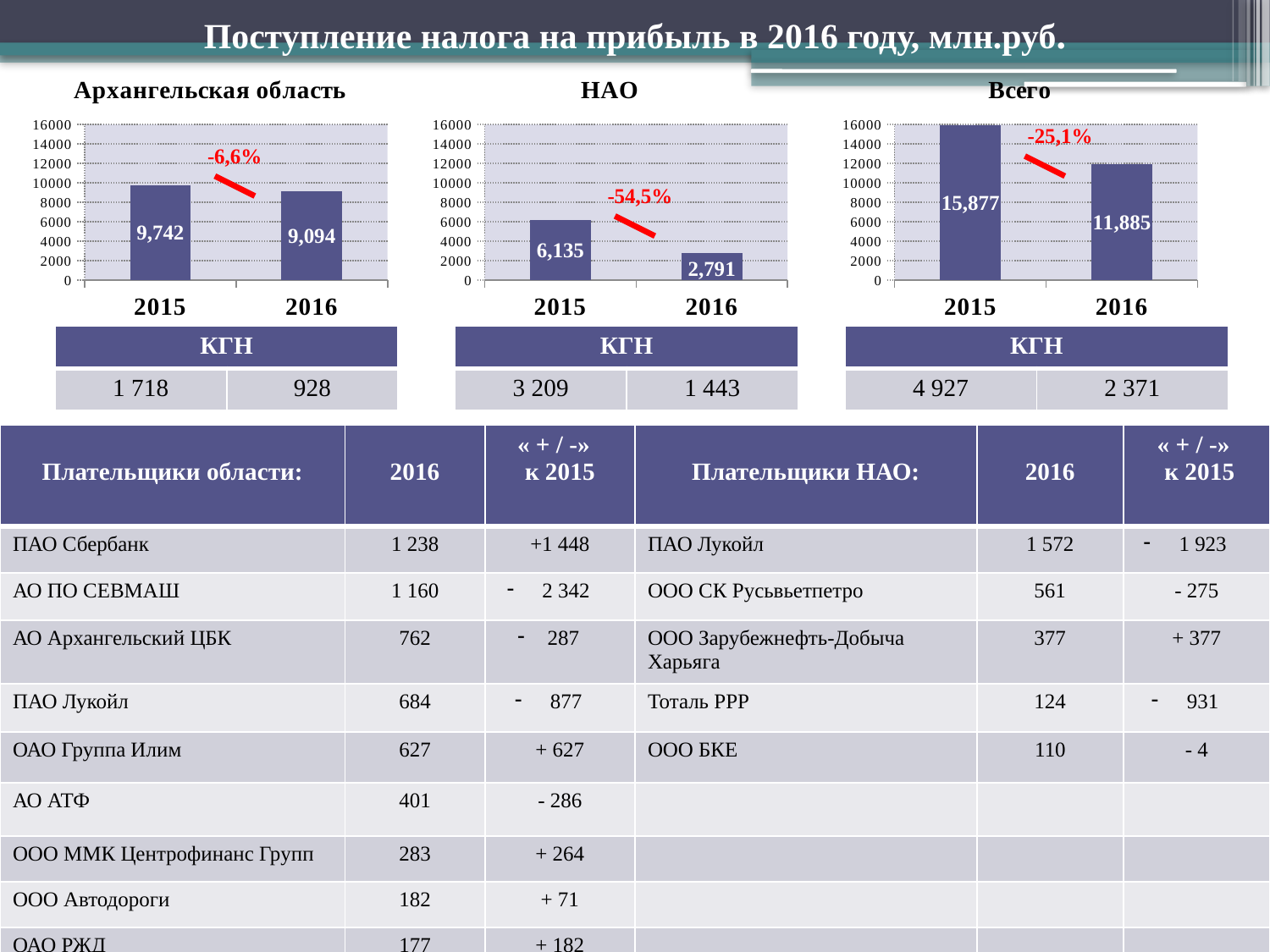
In the 'Архангельская область' chart, what is the value for 2016? 9,094 In the 'НАО' chart, is the value for 2015 greater or less than 4000? greater What kind of chart is the 'Всего' chart? bar chart In the 'Архангельская область' chart, what is the value for 2015? 9,742 In the 'НАО' chart, what is the value for 2016? 2,791 In the 'Всего' chart, what is the value for 2016? 11,885 In the 'Архангельская область' chart, what is the difference between the 2015 and 2016 values? 648 In the 'НАО' chart, do the values rise or fall from 2015 to 2016? fall In the 'Всего' chart, what is the value for 2015? 15,877 What percentage change is annotated on the 'Всего' chart? -25,1% In the 'Всего' chart, which year has the lowest value? 2016 In the 'НАО' chart, which year has the higher value, 2015 or 2016? 2015